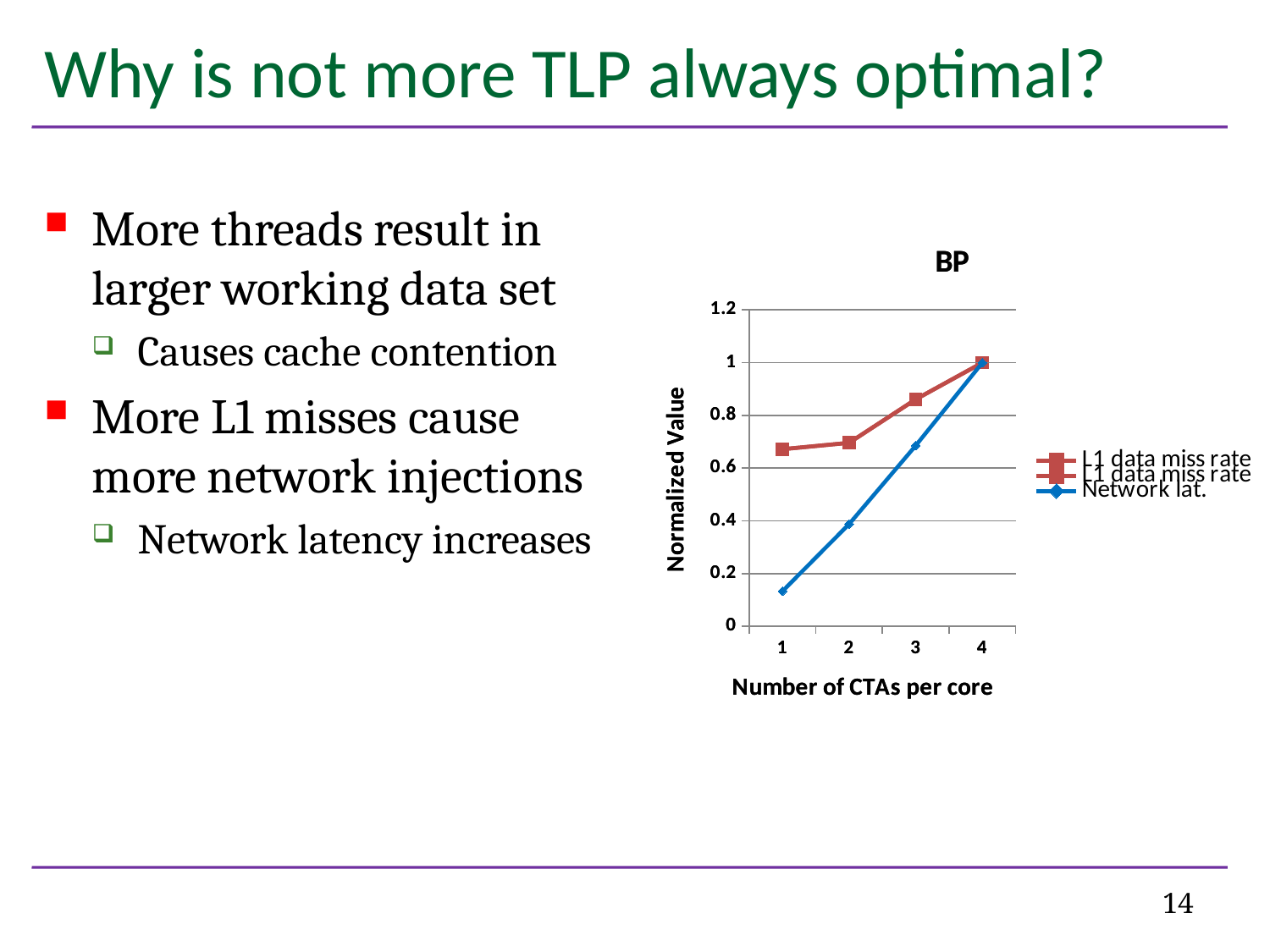
Is the value for Network lat. at 1 CTA per core greater or less than 0.2? less Does the Network lat. series rise or fall as the number of CTAs per core increases? rise At 1 CTA per core, which series has the larger value, L1 data miss rate or Network lat.? L1 data miss rate Is the value for L1 data miss rate at 1 CTA per core greater or less than 0.6? greater How many points are plotted along the x axis for each series? 4 What is the title of the chart? BP At which number of CTAs per core is the Network lat. value lowest? 1 What is the normalized value of Network lat. at 4 CTAs per core? 1 Does the L1 data miss rate series rise or fall as the number of CTAs per core increases? rise What is the label of the x axis of the chart? Number of CTAs per core What kind of chart is shown on the slide? line chart What is the normalized value of L1 data miss rate at 4 CTAs per core? 1